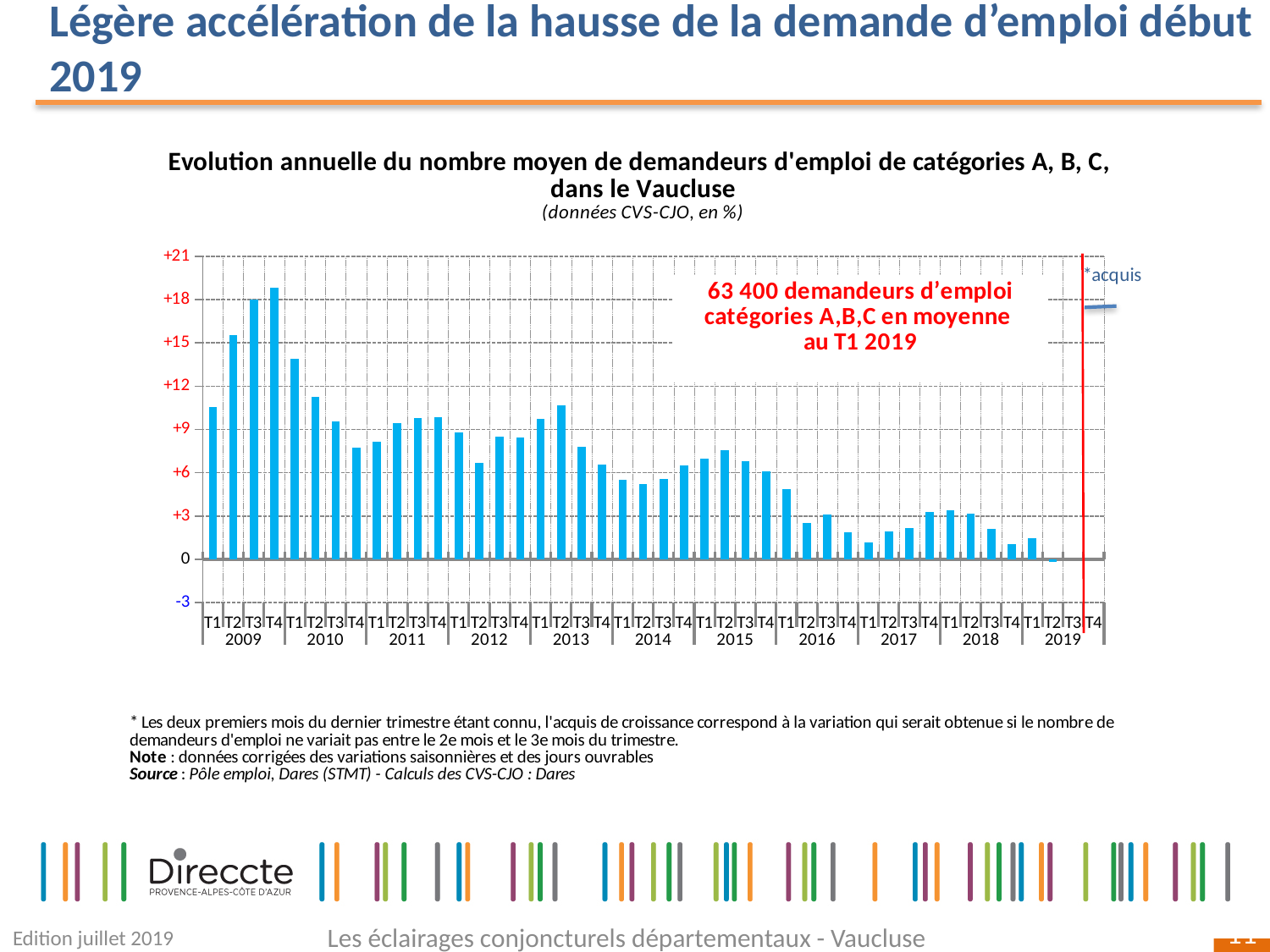
Do the values rise or fall from T4 2009 to T1 2011? fall Is the value for T1 2009 greater or less than +9? greater According to the annotation on the chart, what was the average number of category A, B, C job seekers in T1 2019? 63 400 Is the value for T4 2018 greater or less than +3? less How many years are labelled on the x axis of the chart? 11 Which is larger, the value for T1 2009 or the value for T1 2015? T1 2009 Is the value for T2 2013 greater or less than +9? greater What kind of chart is shown on the slide? bar chart Which quarter has the highest value in the chart? T4 2009 Do the values rise or fall from T1 2009 to T4 2009? rise